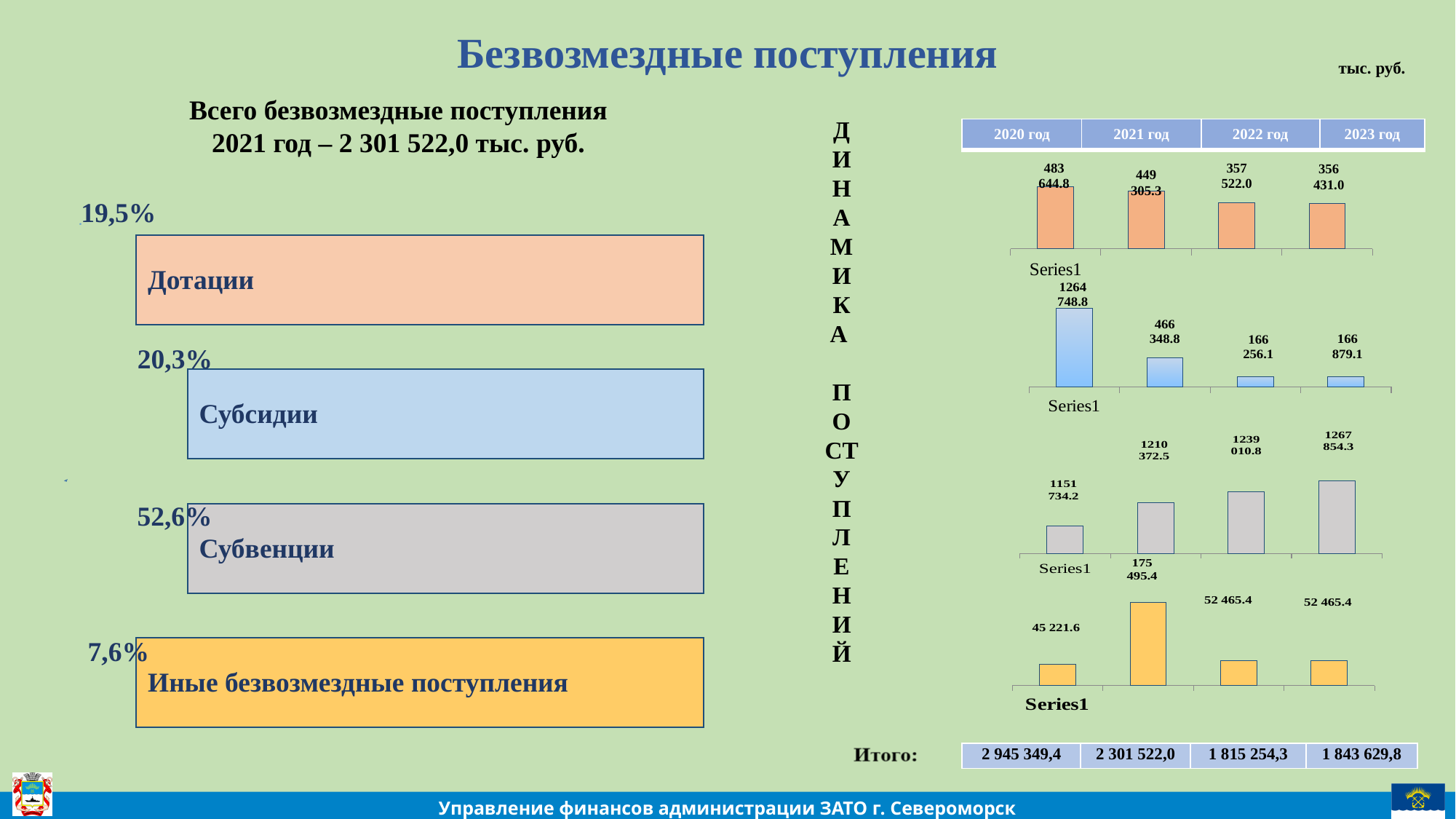
In the second (blue) bar chart on the right, which year has the highest value? 2020 год In the second (blue) bar chart on the right, what is the value for 2021 год? 466 348.8 In the bottom (yellow) bar chart on the right, is the value for 2021 год larger or smaller than the value for 2022 год? larger In the bottom (yellow) bar chart on the right, what is the value for 2020 год? 45 221.6 In the top (orange) bar chart on the right, which year has the lowest value? 2023 год In the bottom (yellow) bar chart on the right, which year has the highest value? 2021 год In the third (grey) bar chart on the right, what is the value for 2023 год? 1267 854.3 In the second (blue) bar chart on the right, do the values generally rise or fall from 2020 to 2023? fall In the third (grey) bar chart on the right, do the values rise or fall from 2020 to 2023? rise What type of chart are the four small charts on the right side of the slide? bar chart How many bars does each of the small charts on the right have? 4 In the top (orange) bar chart on the right, what is the value for 2020 год? 483 644.8